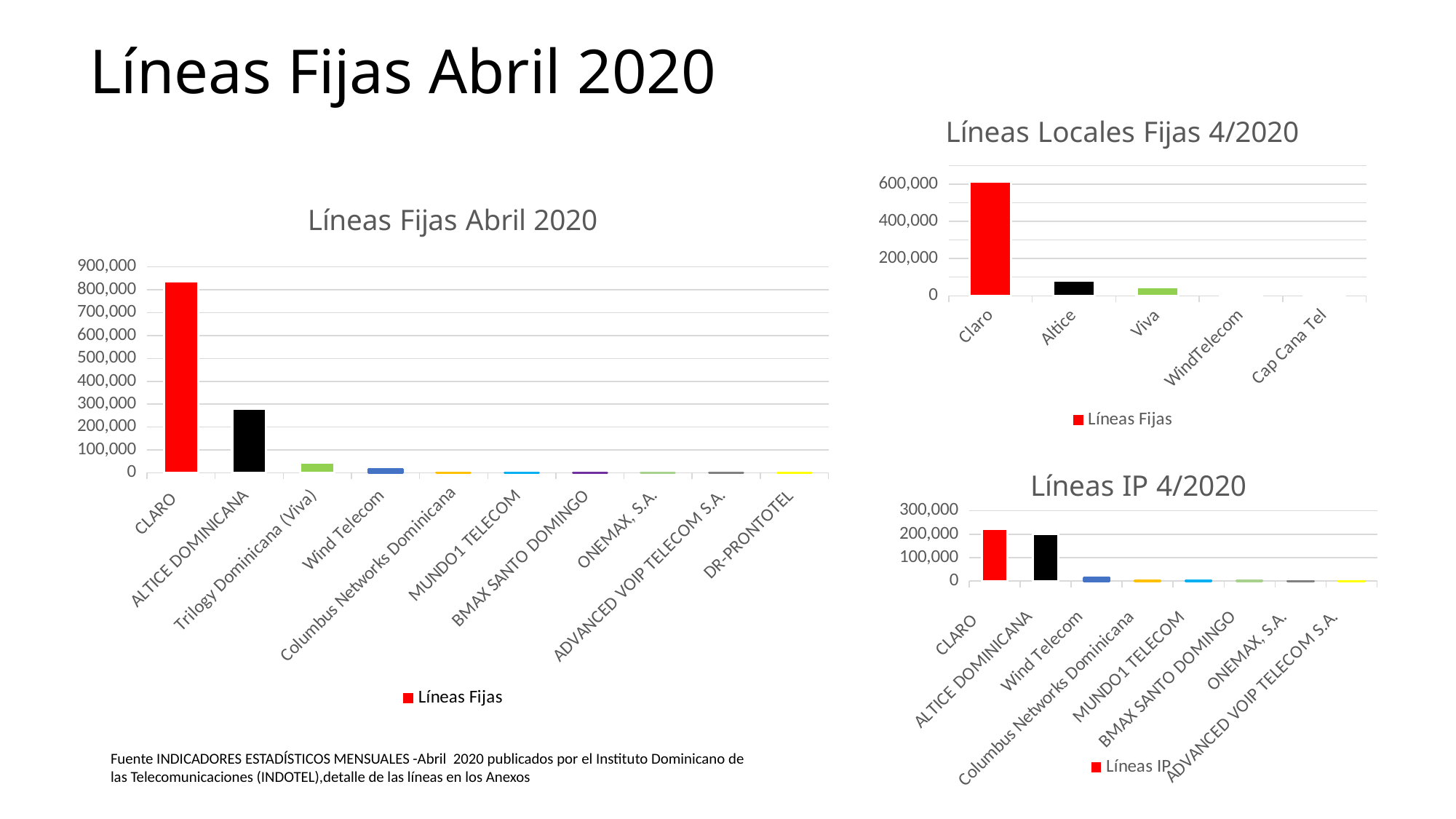
What kind of chart is the chart titled 'Líneas IP 4/2020'? bar chart In the chart titled 'Líneas Fijas Abril 2020', which category has the highest value? CLARO In the chart titled 'Líneas Locales Fijas 4/2020', is the value for Altice greater or less than 200,000? less In the chart titled 'Líneas Fijas Abril 2020', which is larger, the value for ALTICE DOMINICANA or the value for Wind Telecom? ALTICE DOMINICANA In the chart titled 'Líneas Fijas Abril 2020', is the value for Trilogy Dominicana (Viva) greater or less than 100,000? less In the chart titled 'Líneas IP 4/2020', is the value for Wind Telecom greater or less than 100,000? less In the chart titled 'Líneas IP 4/2020', how many categories are shown on the x axis? 8 In the chart titled 'Líneas Fijas Abril 2020', how many categories are shown on the x axis? 10 In the chart titled 'Líneas Locales Fijas 4/2020', which category has the highest value? Claro In the chart titled 'Líneas Locales Fijas 4/2020', how many categories are shown on the x axis? 5